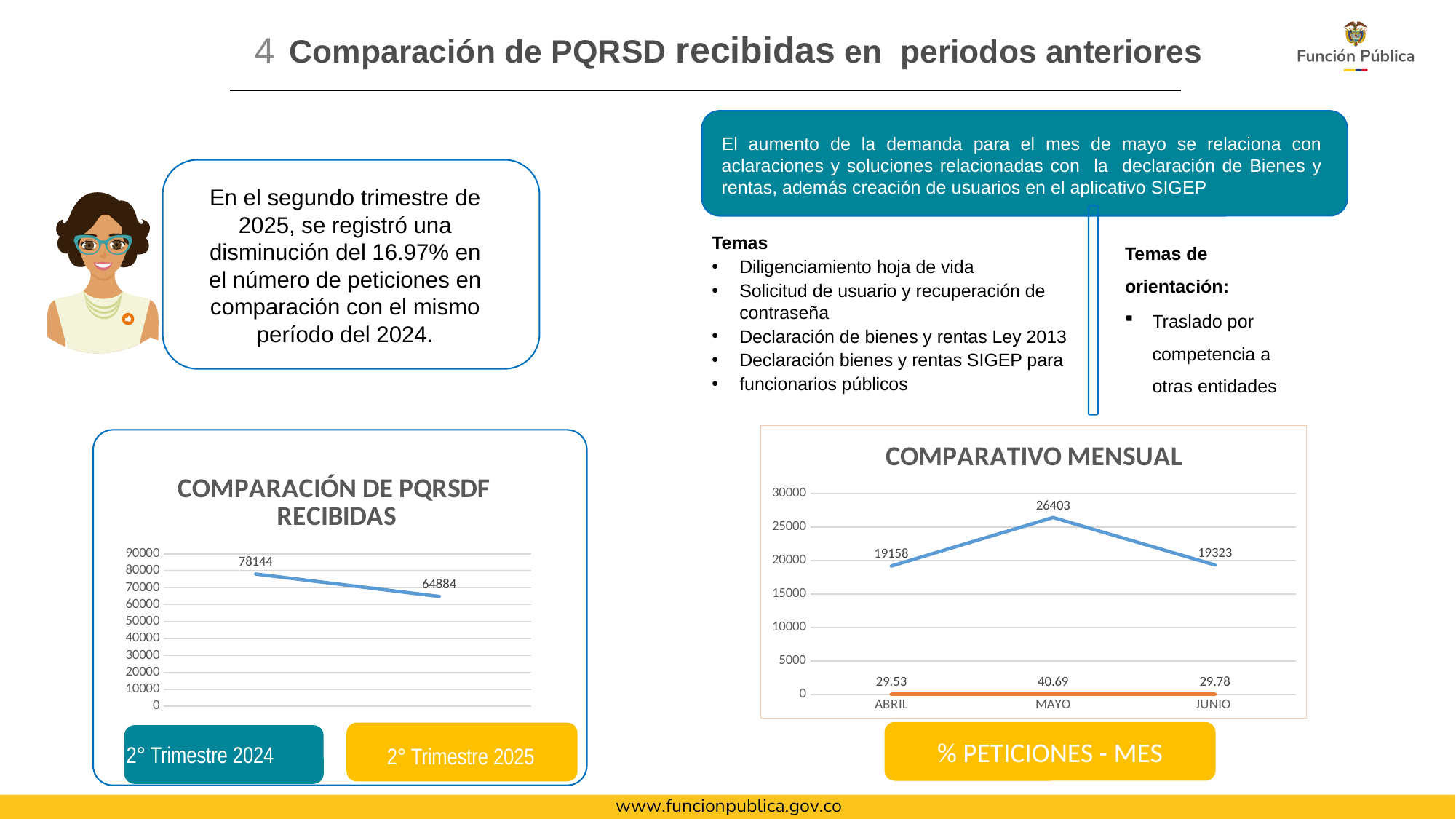
In the 'COMPARACIÓN DE PQRSDF RECIBIDAS' chart, what is the value for 2° Trimestre 2024? 78144 In the 'COMPARATIVO MENSUAL' chart, which month has the highest value on the blue line? MAYO How many months are plotted in the 'COMPARATIVO MENSUAL' chart? 3 In the 'COMPARACIÓN DE PQRSDF RECIBIDAS' chart, what is the value for 2° Trimestre 2025? 64884 What kind of chart is 'COMPARACIÓN DE PQRSDF RECIBIDAS'? line chart In the 'COMPARACIÓN DE PQRSDF RECIBIDAS' chart, what is the difference between the 2° Trimestre 2024 and 2° Trimestre 2025 values? 13260 In the 'COMPARATIVO MENSUAL' chart, what percentage is shown for MAYO on the orange line? 40.69 In the 'COMPARACIÓN DE PQRSDF RECIBIDAS' chart, do the values rise or fall from 2° Trimestre 2024 to 2° Trimestre 2025? fall In the 'COMPARATIVO MENSUAL' chart, which month has the lowest value on the blue line? ABRIL In the 'COMPARATIVO MENSUAL' chart, what is the value for MAYO on the blue line? 26403 In the 'COMPARATIVO MENSUAL' chart, what is the difference between the MAYO and JUNIO values on the blue line? 7080 In the 'COMPARATIVO MENSUAL' chart, what is the value for ABRIL on the blue line? 19158